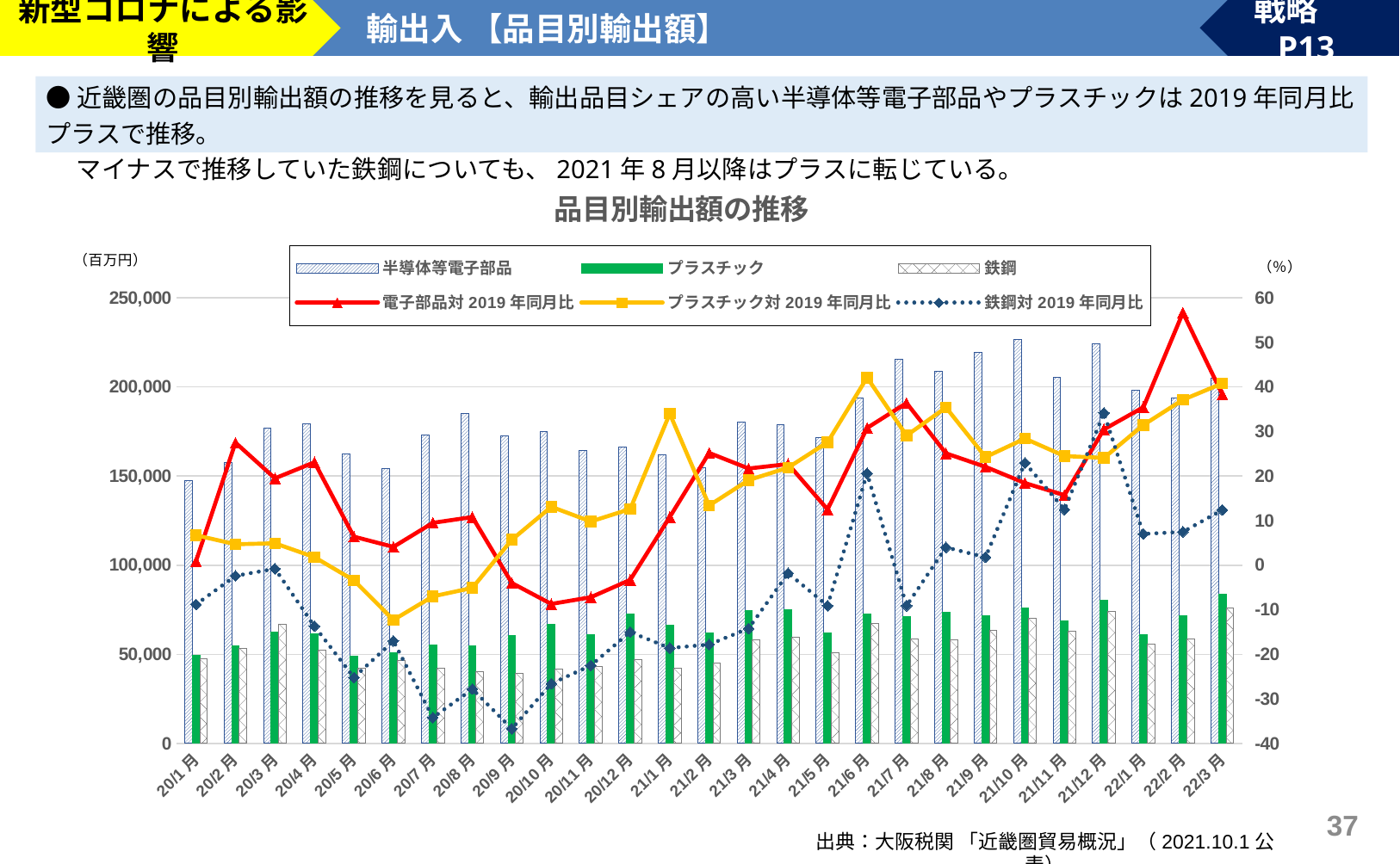
In 品目別輸出額の推移, is the 半導体等電子部品 bar for 21/10月 greater or less than 200,000? greater In 品目別輸出額の推移, is the 鉄鋼 bar for 20/5月 greater or less than 50,000? less What kind of chart is 品目別輸出額の推移? A combined bar and line chart What unit is shown on the right axis of 品目別輸出額の推移? % How many months are shown on the x axis of 品目別輸出額の推移? 27 In 品目別輸出額の推移, in which month does the 鉄鋼対2019年同月比 line reach its highest value? 21/12月 What unit is shown on the left axis of 品目別輸出額の推移? 百万円 In 品目別輸出額の推移, does the 電子部品対2019年同月比 line rise or fall from 21/11月 to 22/2月? rise In 品目別輸出額の推移, is the 電子部品対2019年同月比 value for 22/2月 greater or less than 50? greater In 品目別輸出額の推移, in which month does the 電子部品対2019年同月比 line reach its highest value? 22/2月 In 品目別輸出額の推移, which bar is taller for 20/1月: 半導体等電子部品 or プラスチック? 半導体等電子部品 How many series does the legend of 品目別輸出額の推移 list? 6